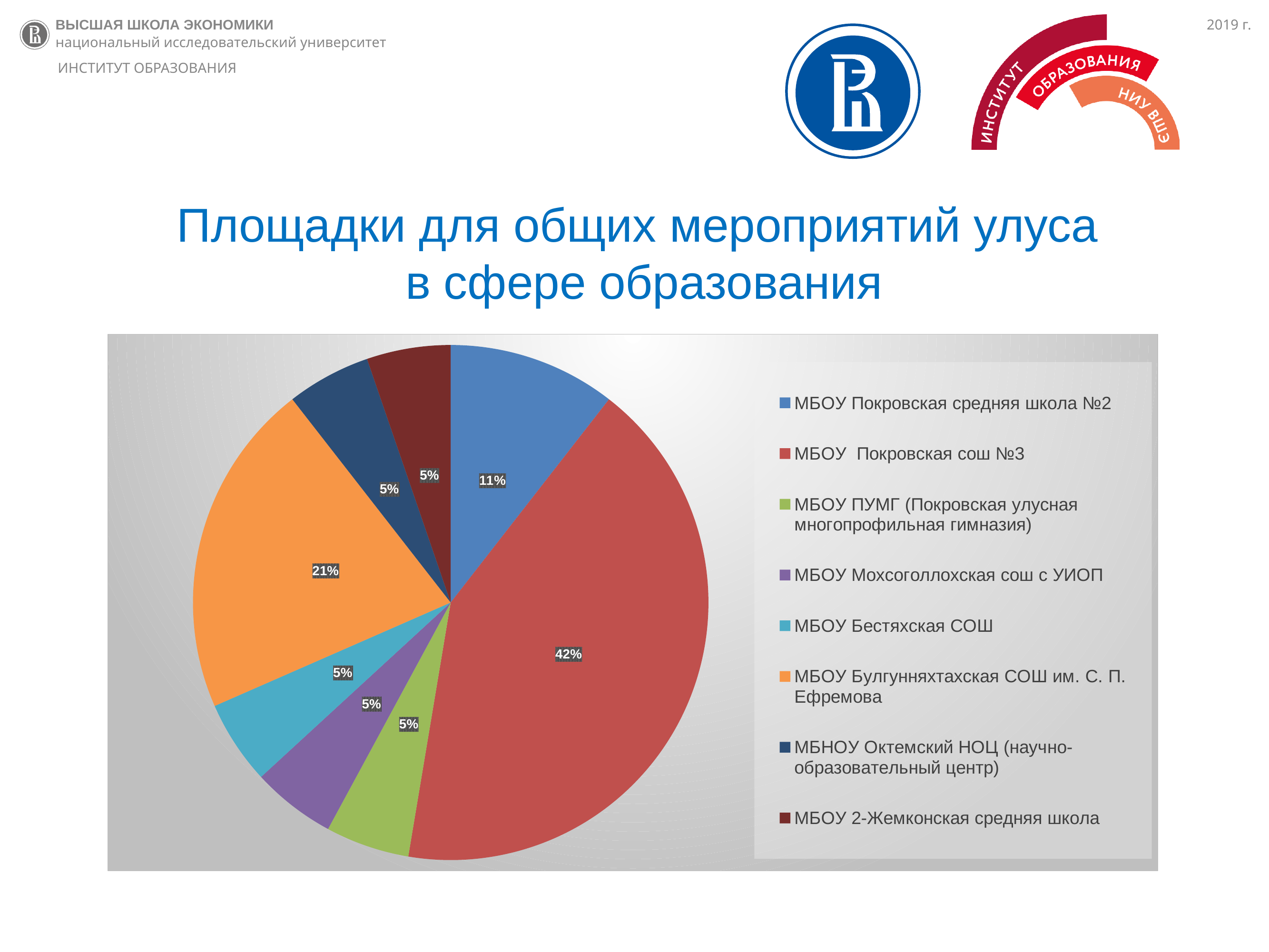
What share of the pie does МБОУ Бестяхская СОШ have? 5% Which is larger: the share of МБОУ Покровская средняя школа №2 or the share of МБОУ 2-Жемконская средняя школа? МБОУ Покровская средняя школа №2 Which category has the largest slice of the pie? МБОУ Покровская сош №3 What is the difference between the shares of МБОУ Покровская средняя школа №2 and МБНОУ Октемский НОЦ (научно-образовательный центр)? 6% What share of the pie does МБОУ Покровская средняя школа №2 have? 11% How many categories does the legend list? 8 What share of the pie does МБОУ Покровская сош №3 have? 42% What is the difference between the shares of МБОУ Покровская сош №3 and МБОУ Булгунняхтахская СОШ им. С. П. Ефремова? 21% How many categories have a share of 5%? 5 What kind of chart is shown on the slide? pie chart What colour is the slice for МБОУ Булгунняхтахская СОШ им. С. П. Ефремова? orange